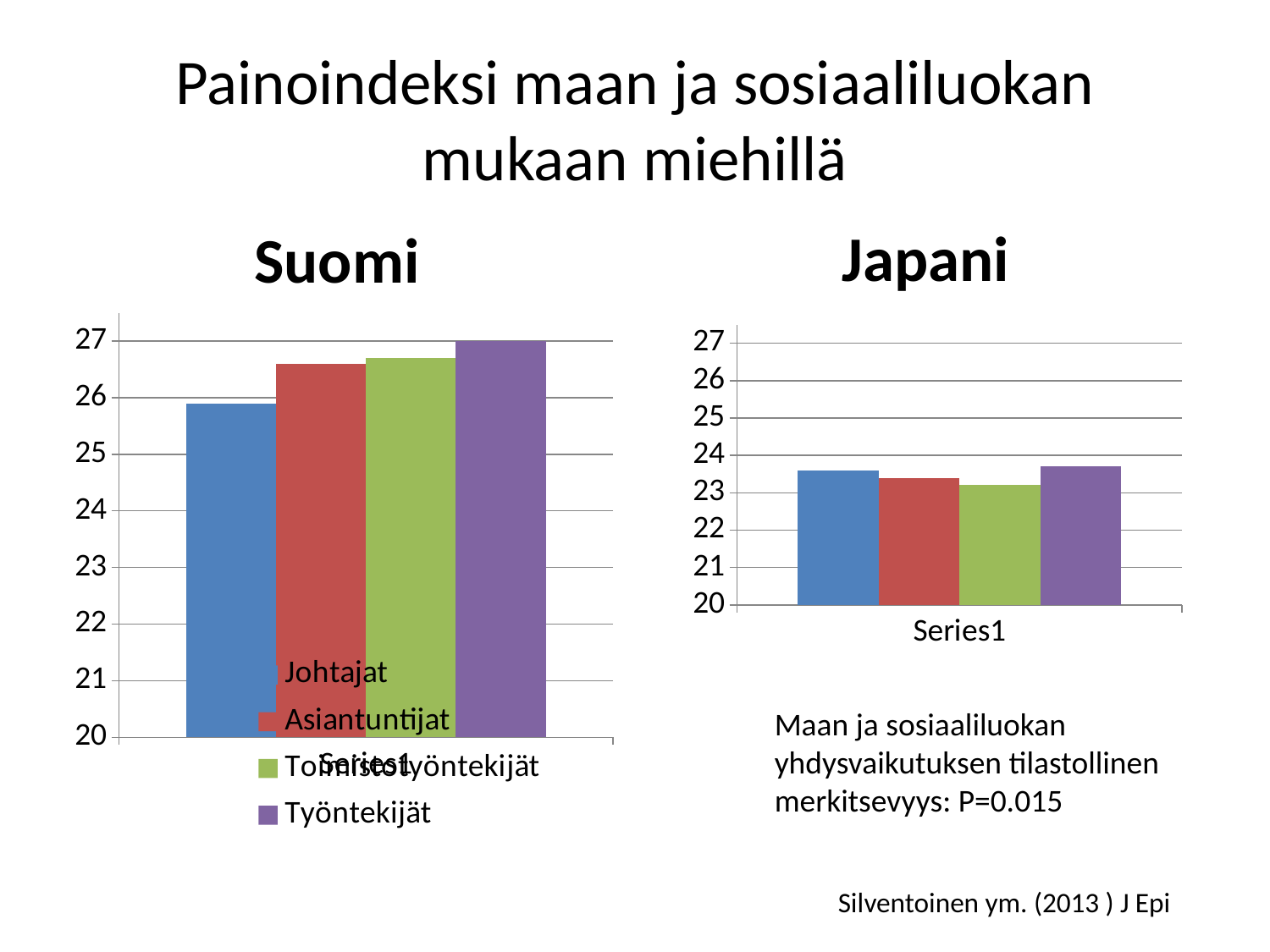
How many series does the legend of the Suomi chart list? 4 In the Japani chart, which series has the lowest value? Toimistotyöntekijät In the Suomi chart, which series has the lowest value? Johtajat In the Suomi chart, which is larger, the value for Johtajat or the value for Asiantuntijat? Asiantuntijat Which is larger, the value for Johtajat in the Suomi chart or the value for Johtajat in the Japani chart? Suomi In the Suomi chart, what colour represents the Työntekijät series? purple In the Japani chart, is the value for Johtajat greater or less than 23? greater What kind of chart is the Suomi chart? bar chart How many bars are plotted in the Japani chart? 4 In the Suomi chart, is the value for Johtajat greater or less than 25? greater In the Suomi chart, which series has the highest value? Työntekijät